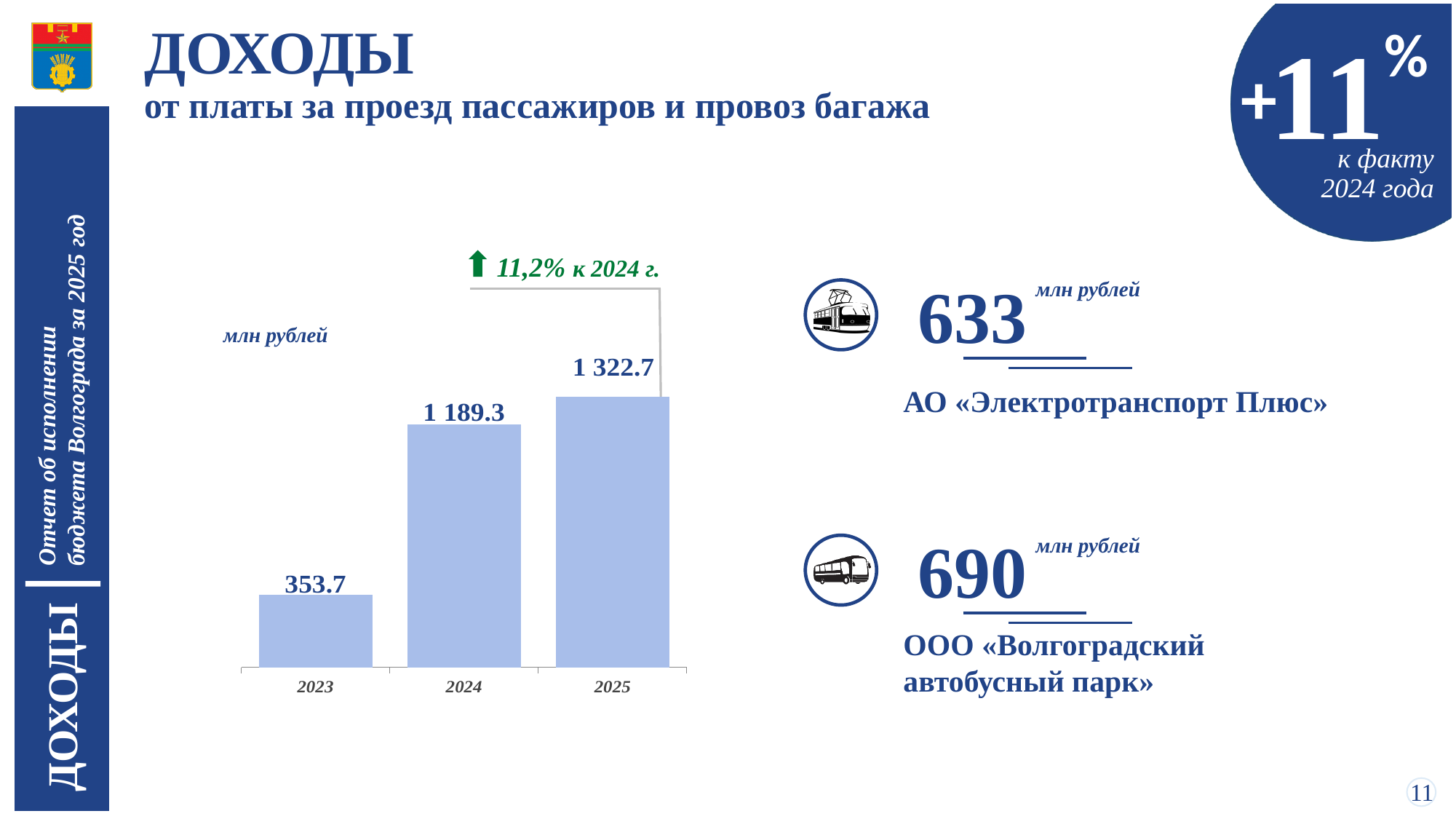
Which is larger on the bar chart, the value for 2024 or the value for 2023? 2024 Which year has the lowest value on the bar chart? 2023 What is the value shown for 2025 on the bar chart? 1 322.7 What is the difference between the 2024 and 2023 values on the bar chart? 835.6 Which year has the highest value on the bar chart? 2025 What is the value shown for 2023 on the bar chart? 353.7 What is the value shown for 2024 on the bar chart? 1 189.3 What unit is indicated for the values on the bar chart? млн рублей Do the values on the bar chart rise or fall from 2023 to 2025? rise What kind of chart is shown on the slide? bar chart How many years are shown on the bar chart? 3 What is the difference between the 2025 and 2024 values on the bar chart? 133.4